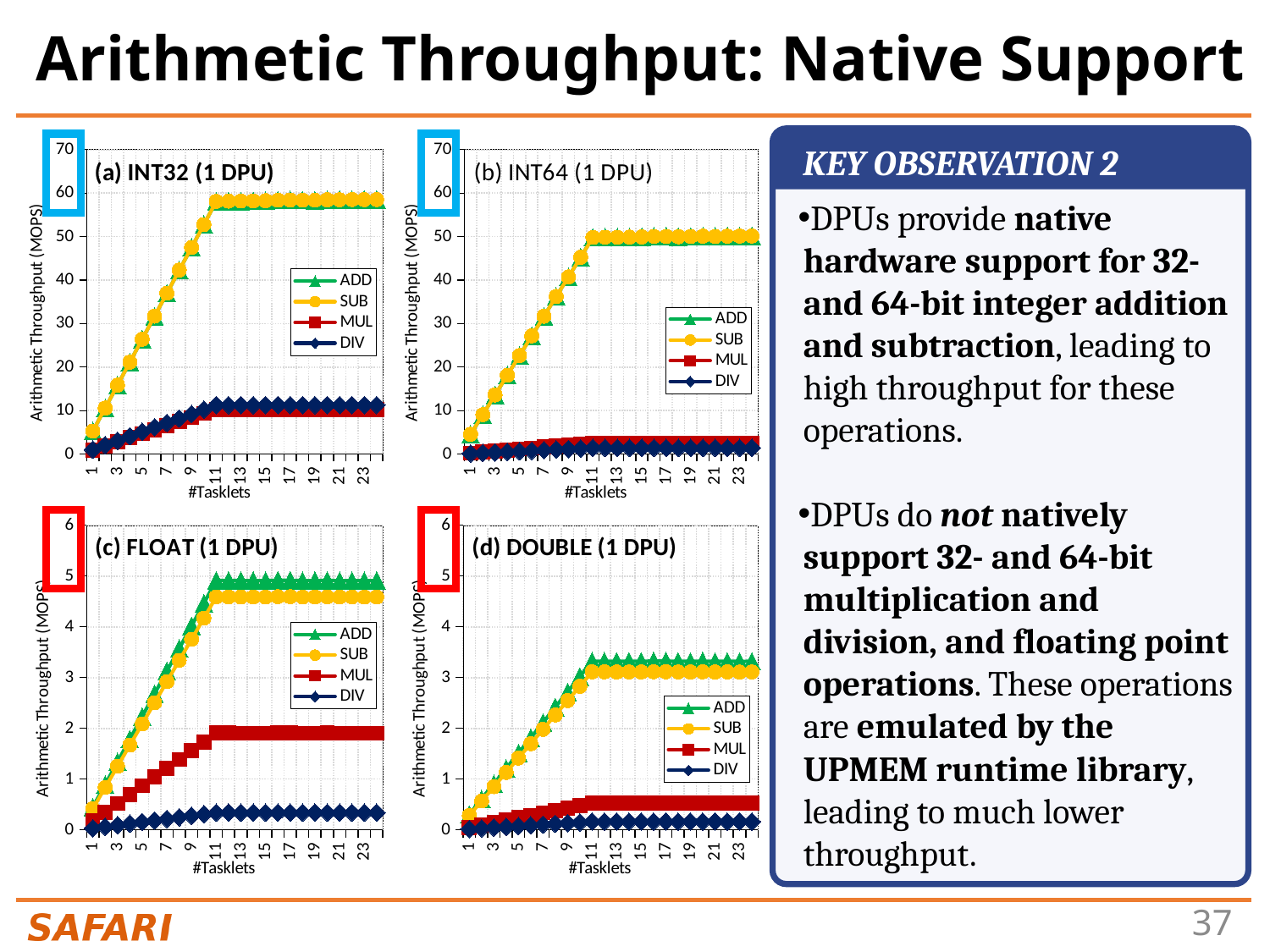
In the '(d) DOUBLE (1 DPU)' chart, is the ADD throughput at 23 tasklets greater or less than 4 MOPS? less In the '(a) INT32 (1 DPU)' chart, which is larger at 23 tasklets, the ADD throughput or the MUL throughput? ADD In the '(d) DOUBLE (1 DPU)' chart, which is larger at 23 tasklets, the MUL throughput or the DIV throughput? MUL What is the label on the x axis of the '(c) FLOAT (1 DPU)' chart? #Tasklets In the '(c) FLOAT (1 DPU)' chart, is the MUL throughput at 23 tasklets greater or less than 1 MOPS? greater In the '(c) FLOAT (1 DPU)' chart, which series has the lowest throughput at 23 tasklets? DIV What kind of chart is the '(a) INT32 (1 DPU)' chart? line chart In the '(b) INT64 (1 DPU)' chart, does the ADD throughput rise or fall as the number of tasklets increases from 1 to 11? rise How many series does the legend of the '(b) INT64 (1 DPU)' chart list? 4 In the '(b) INT64 (1 DPU)' chart, is the SUB throughput at 23 tasklets greater or less than 60 MOPS? less What is the label on the y axis of the '(d) DOUBLE (1 DPU)' chart? Arithmetic Throughput (MOPS)